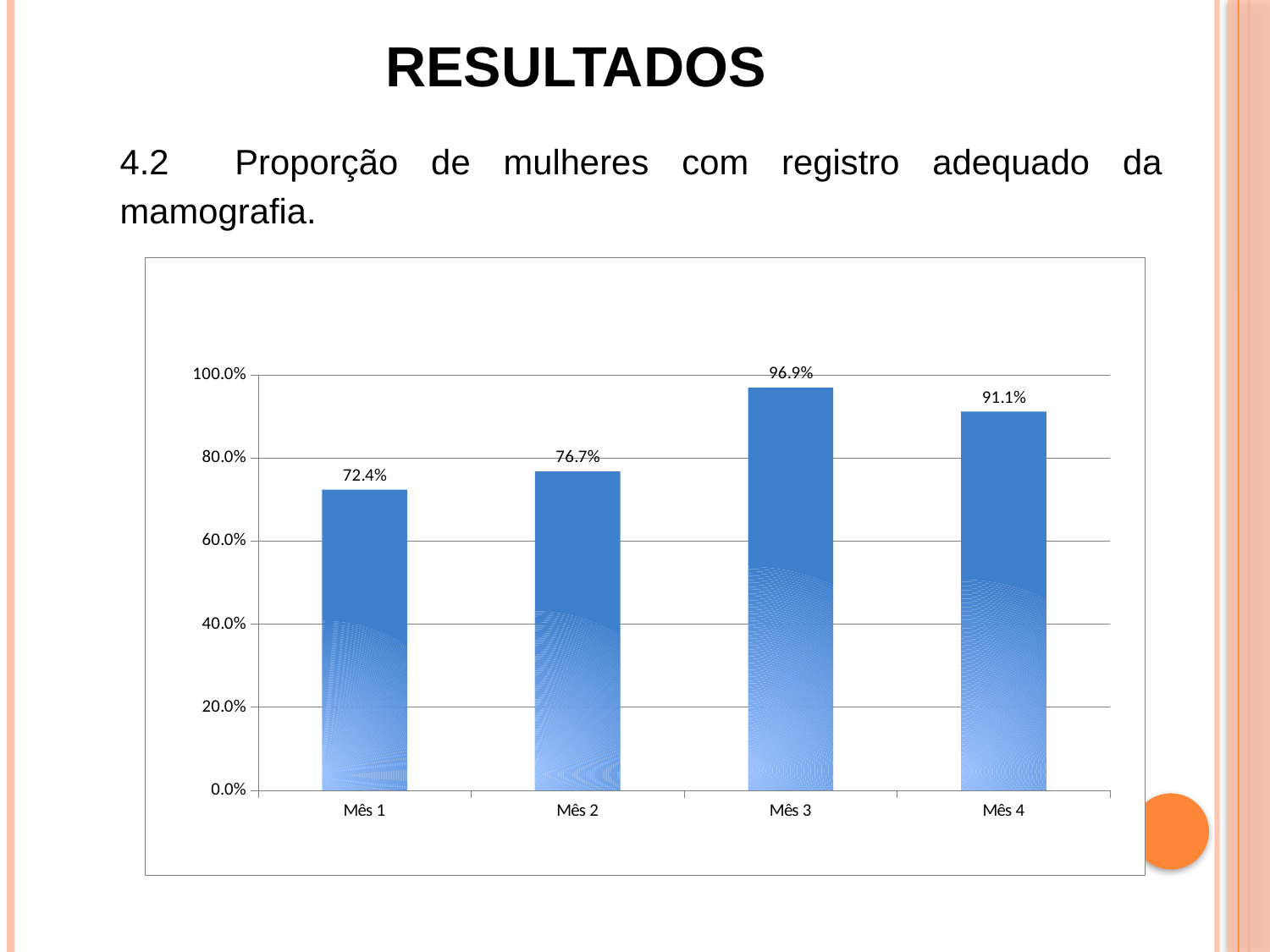
What is the value for Mês 3? 96.9% What kind of chart is shown on the slide? bar chart What is the value for Mês 1? 72.4% Does the value rise or fall from Mês 3 to Mês 4? fall Which is larger, the value for Mês 2 or the value for Mês 4? Mês 4 How many months are shown on the x axis? 4 Is the value for Mês 2 greater or less than 80.0%? less What is the value for Mês 4? 91.1% What is the difference between the values for Mês 2 and Mês 1? 4.3% Which month has the highest value? Mês 3 Which month has the lowest value? Mês 1 What is the difference between the values for Mês 3 and Mês 1? 24.5%